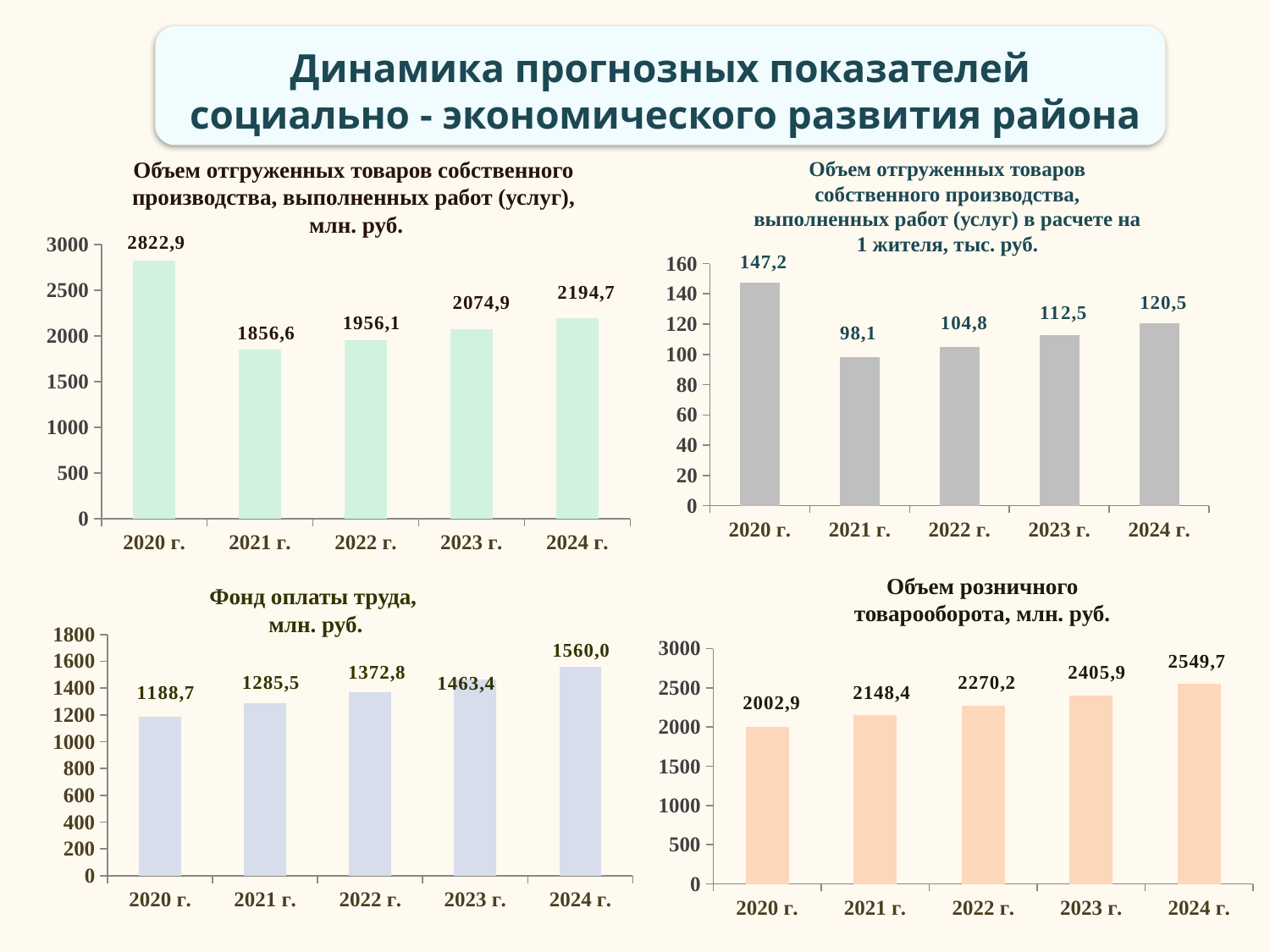
In the bottom-left chart (Фонд оплаты труда, млн. руб.), what is the value for 2022 г.? 1372,8 In the bottom-left chart (Фонд оплаты труда, млн. руб.), do the values rise or fall from 2020 г. to 2024 г.? rise In the top-right chart (в расчете на 1 жителя, тыс. руб.), which year has the highest value? 2020 г. In the top-right chart (в расчете на 1 жителя, тыс. руб.), what is the value for 2023 г.? 112,5 In the bottom-right chart (Объем розничного товарооборота, млн. руб.), what is the value for 2024 г.? 2549,7 In the top-left chart (Объем отгруженных товаров собственного производства, млн. руб.), what is the value for 2020 г.? 2822,9 In the bottom-left chart (Фонд оплаты труда, млн. руб.), what is the difference between the 2024 г. and 2020 г. values? 371,3 In the top-right chart (в расчете на 1 жителя, тыс. руб.), is the value for 2021 г. greater or less than 100? less In the top-left chart (Объем отгруженных товаров собственного производства, млн. руб.), which year has the lowest value? 2021 г. How many years are shown on the x axis of the bottom-right chart (Объем розничного товарооборота, млн. руб.)? 5 In the top-left chart (Объем отгруженных товаров собственного производства, млн. руб.), what is the difference between the 2020 г. and 2021 г. values? 966,3 In the bottom-right chart (Объем розничного товарооборота, млн. руб.), which is larger: the value for 2021 г. or 2022 г.? 2022 г.